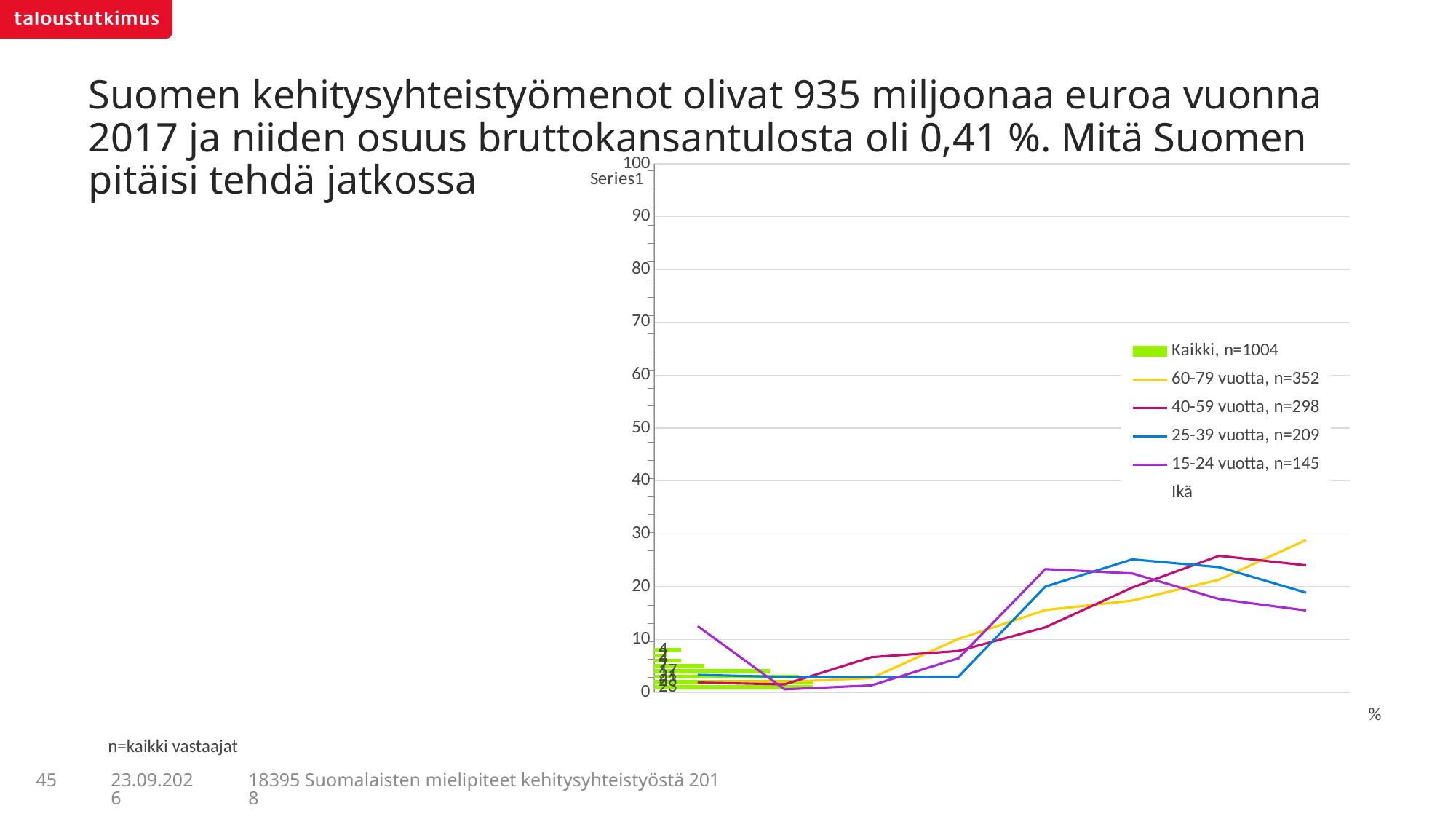
How many series does the chart legend list? 6 Is the highest point of the 25-39 vuotta line greater or less than 20? greater Which legend series is drawn in green? Kaikki, n=1004 At the rightmost point of the lines, which age-group series has the lowest value? 15-24 vuotta, n=145 At the rightmost point of the lines, which age-group series has the highest value? 60-79 vuotta, n=352 Does the 60-79 vuotta line generally rise or fall from left to right? rise At the rightmost point, is the value for the 60-79 vuotta line greater or less than 20? greater At the rightmost point, which is larger: the 60-79 vuotta line or the 15-24 vuotta line? 60-79 vuotta, n=352 At the rightmost point, is the value for the 60-79 vuotta line greater or less than 30? less At the rightmost point, which is larger: the 40-59 vuotta line or the 25-39 vuotta line? 40-59 vuotta, n=298